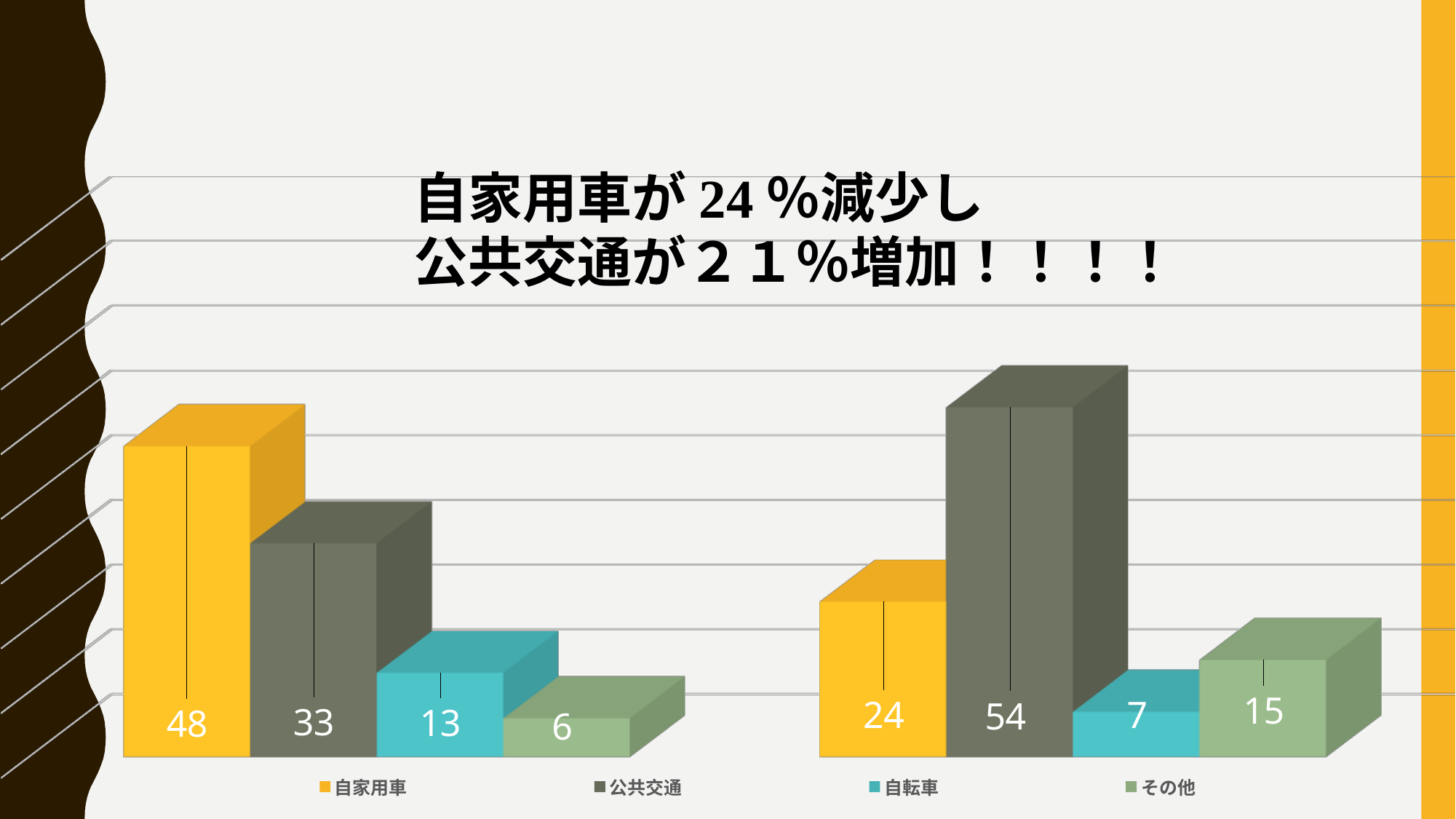
Which series has the highest value in the left group of bars? 自家用車 What is the value for その他 in the left group of bars? 6 What kind of chart is shown on the slide? bar chart What is the value for 公共交通 in the right group of bars? 54 What is the difference between the 公共交通 values in the right group and the left group? 21 What is the value for 自家用車 in the left group of bars? 48 How many series does the legend list? 4 What is the difference between the 自家用車 values in the left group and the right group? 24 Which is larger in the right group of bars: 自家用車 or 公共交通? 公共交通 What is the value for 自転車 in the right group of bars? 7 Which colour represents 自転車 in the legend? teal (light blue) Which series has the lowest value in the right group of bars? 自転車